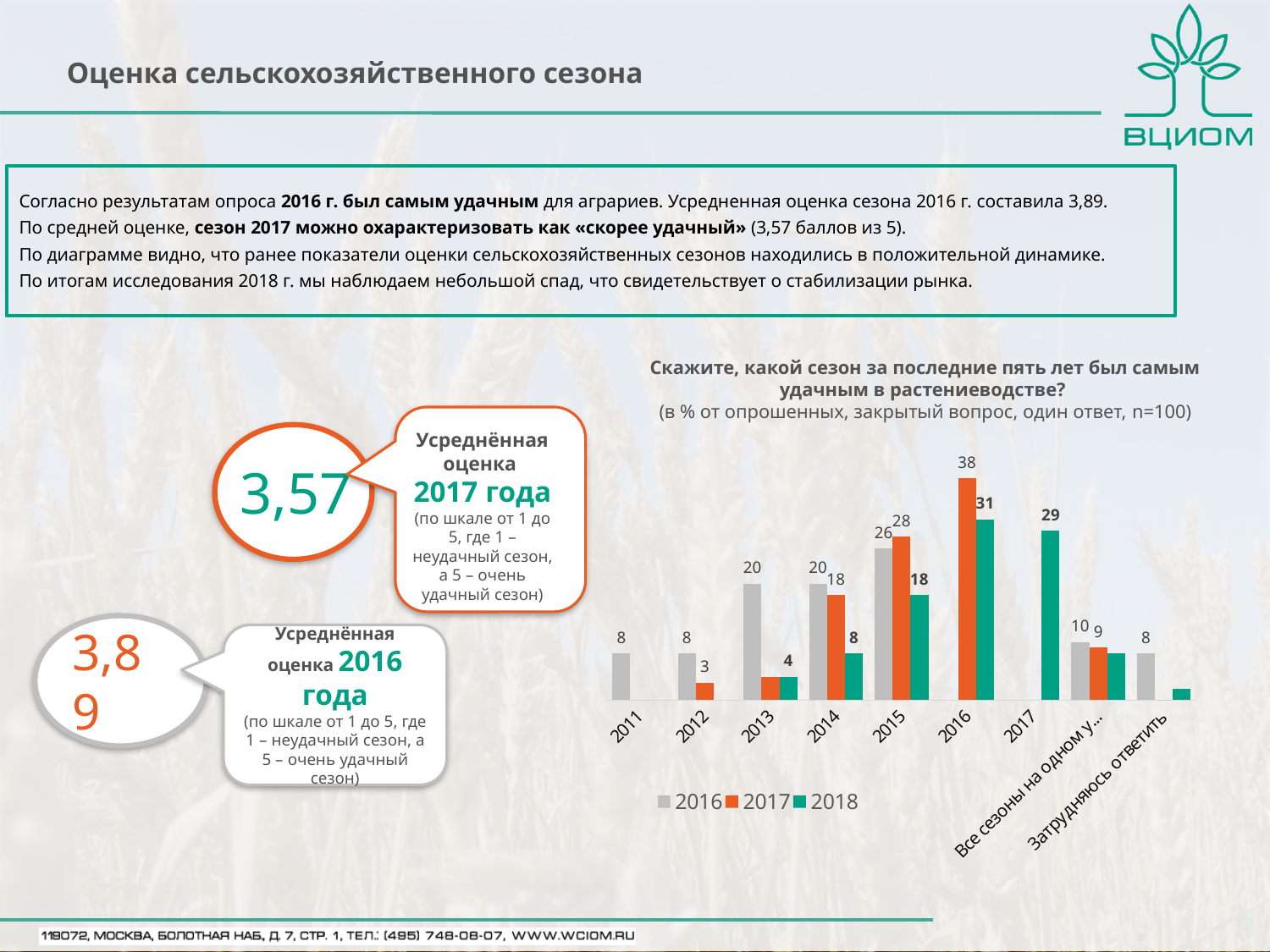
In the bar chart, which category has the highest value for the 2016 series? 2015 In the bar chart, what is the value of the 2017 series for the category 2015? 28 How many series does the legend of the bar chart list? 3 In the bar chart, what is the value of the 2018 series for the category 2017? 29 What kind of chart is shown on the slide? bar chart How many categories are shown along the x axis of the bar chart? 9 In the bar chart, for the category 2015, which series has the larger value: 2016 or 2017? 2017 In the bar chart, what is the value of the 2017 series for the category 2012? 3 Which series does the legend of the bar chart list? 2016, 2017, 2018